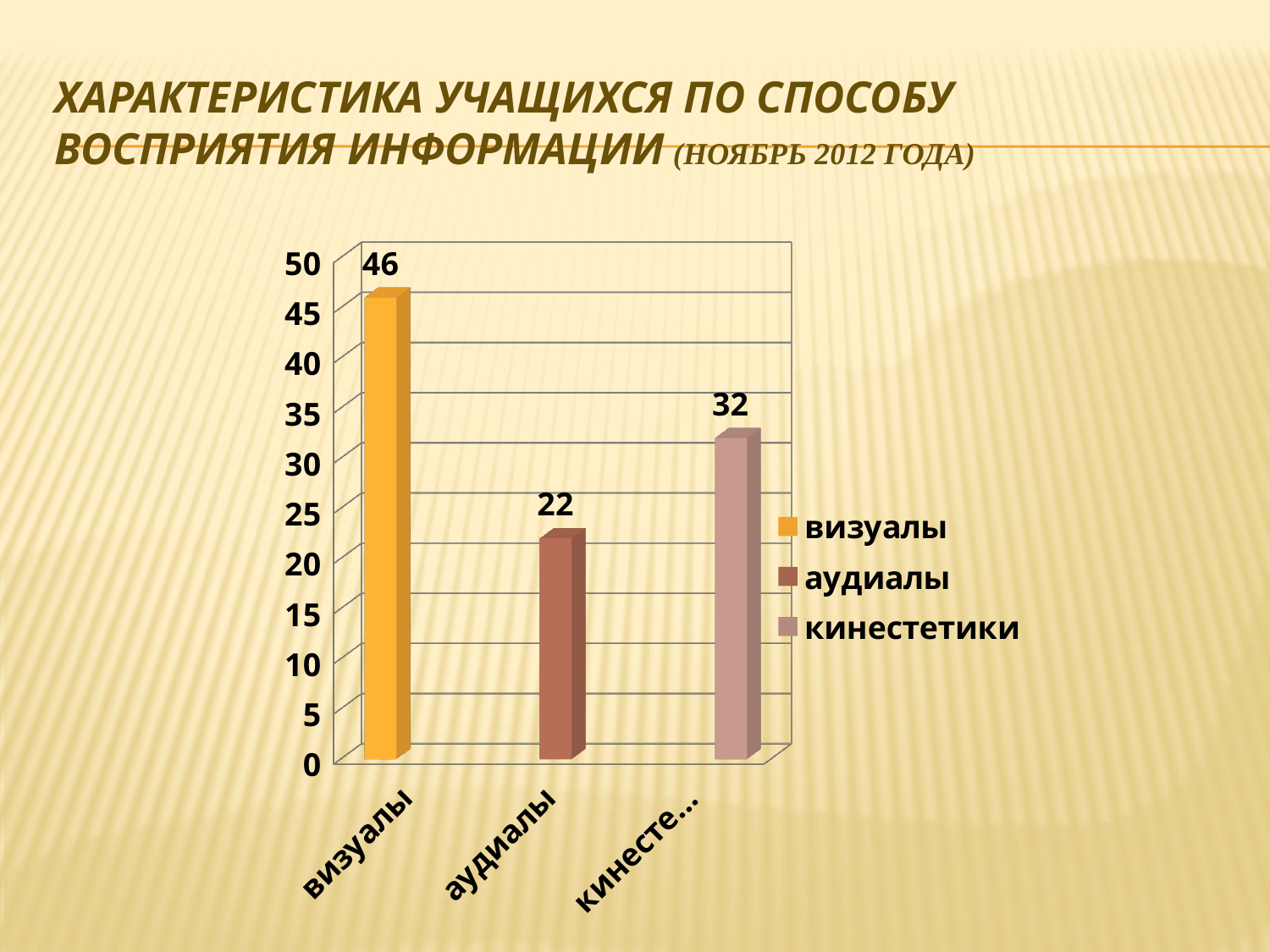
What kind of chart is shown on the slide? bar chart Which is larger, the value for кинестетики or the value for аудиалы? кинестетики What is the difference between the values for кинестетики and аудиалы? 10 What is the value for визуалы? 46 Which category has the highest value? визуалы Is the value for визуалы greater or less than 40? greater What is the difference between the values for визуалы and аудиалы? 24 How many categories are shown on the chart? 3 What is the value for аудиалы? 22 What is the value for кинестетики? 32 Which category has the lowest value? аудиалы How many entries does the legend list? 3